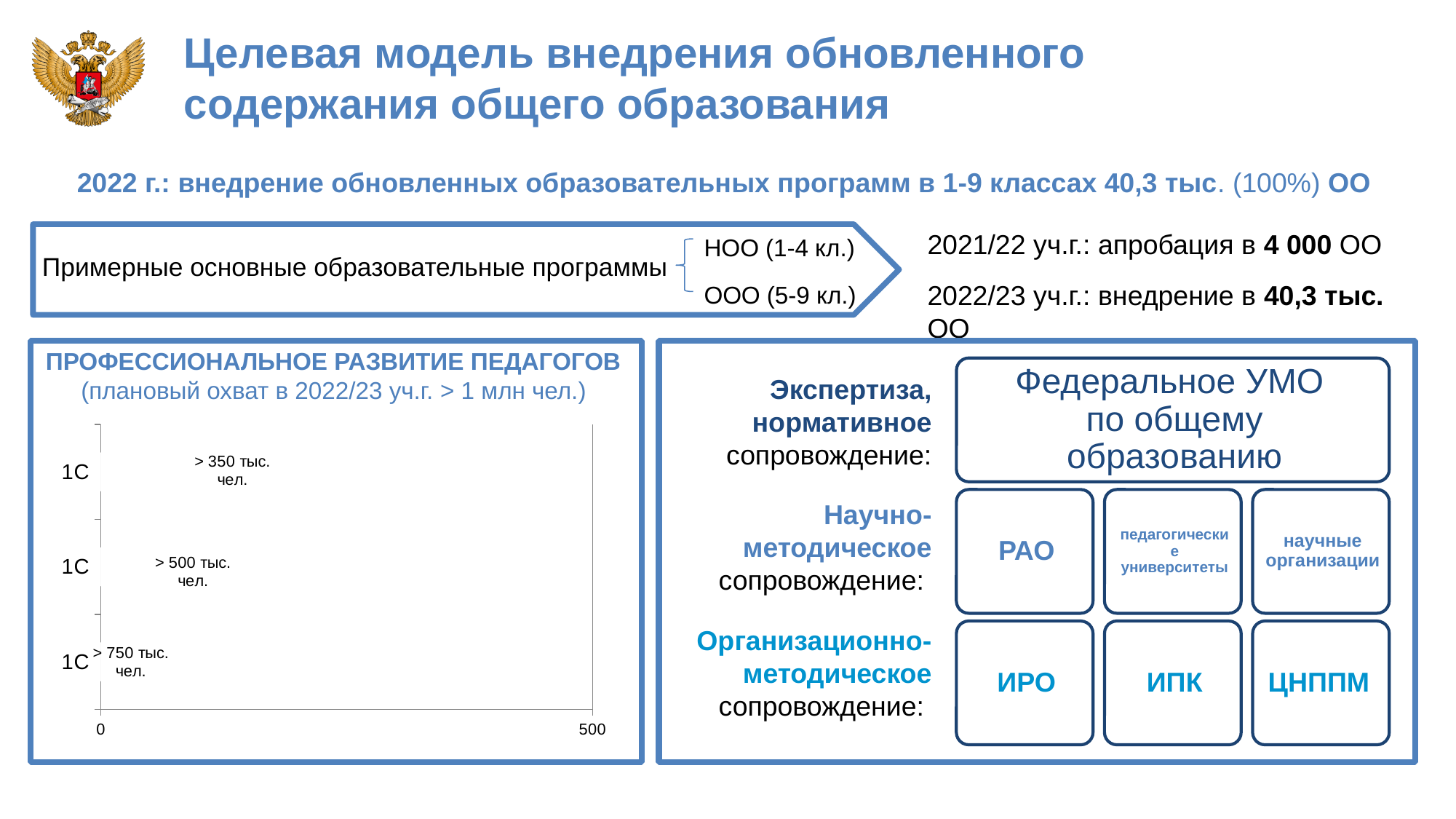
What kind of chart is shown on the left of the slide? bar chart What data label is printed for the top category of the chart? > 350 тыс. чел. What is the highest tick value shown on the chart's horizontal axis? 500 What data label is printed for the bottom category of the chart? > 750 тыс. чел. What is the title of the chart on the left of the slide? ПРОФЕССИОНАЛЬНОЕ РАЗВИТИЕ ПЕДАГОГОВ How many categories are shown on the chart's vertical axis? 3 What data label is printed for the middle category of the chart? > 500 тыс. чел.